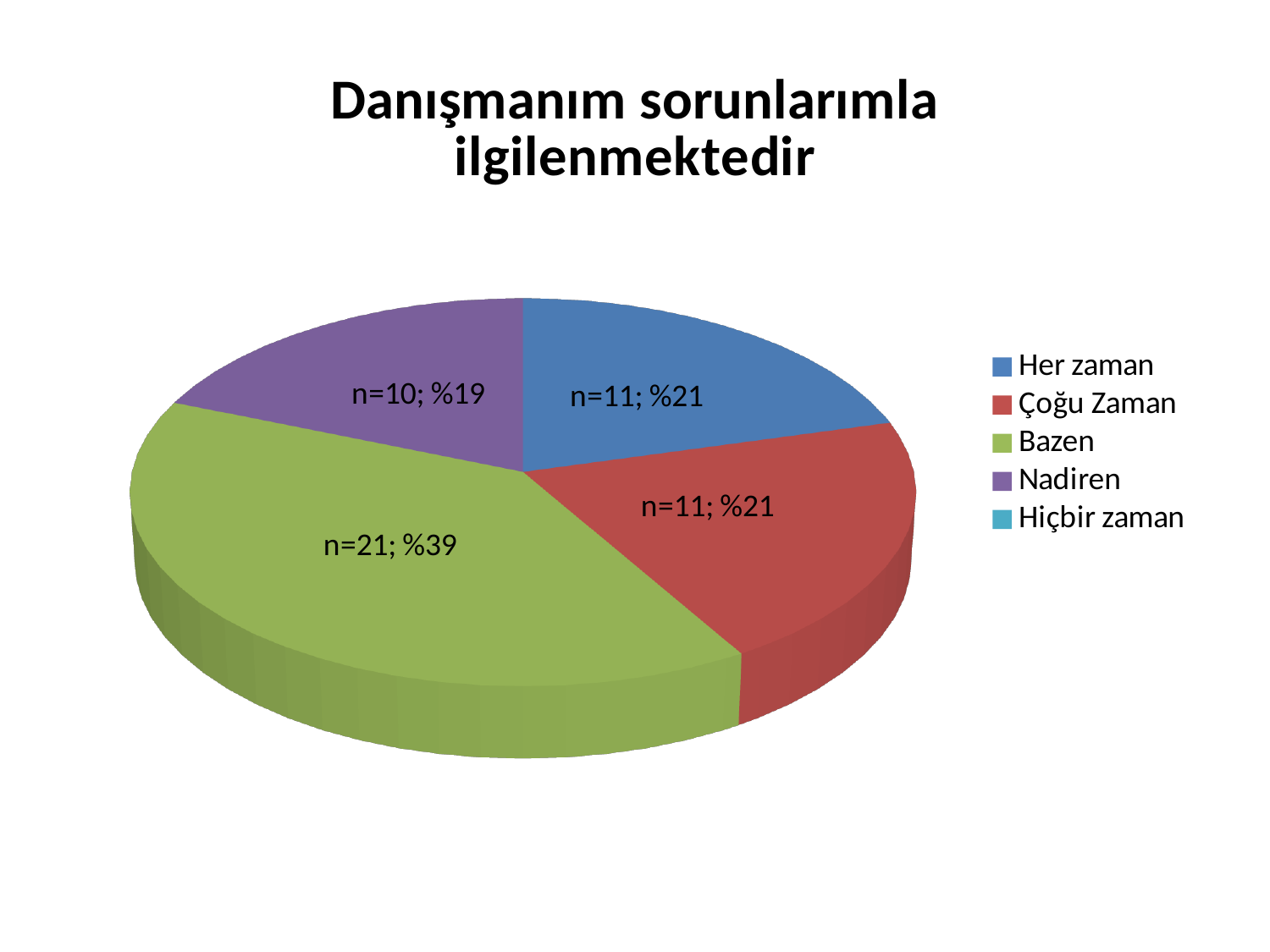
How many slices are visible in the pie? 4 Which category has the largest slice? Bazen What is the data label for the Her zaman slice? n=11; %21 What share of the pie does the Çoğu Zaman slice represent? %21 Which slice is larger, Bazen or Her zaman? Bazen What is the difference in n between the Bazen slice and the Nadiren slice? 11 What is the title of the chart? Danışmanım sorunlarımla ilgilenmektedir What is the data label for the Nadiren slice? n=10; %19 What is the data label for the Bazen slice? n=21; %39 How many entries does the legend list? 5 Which category has the smallest visible slice? Nadiren What kind of chart is shown on the slide? pie chart